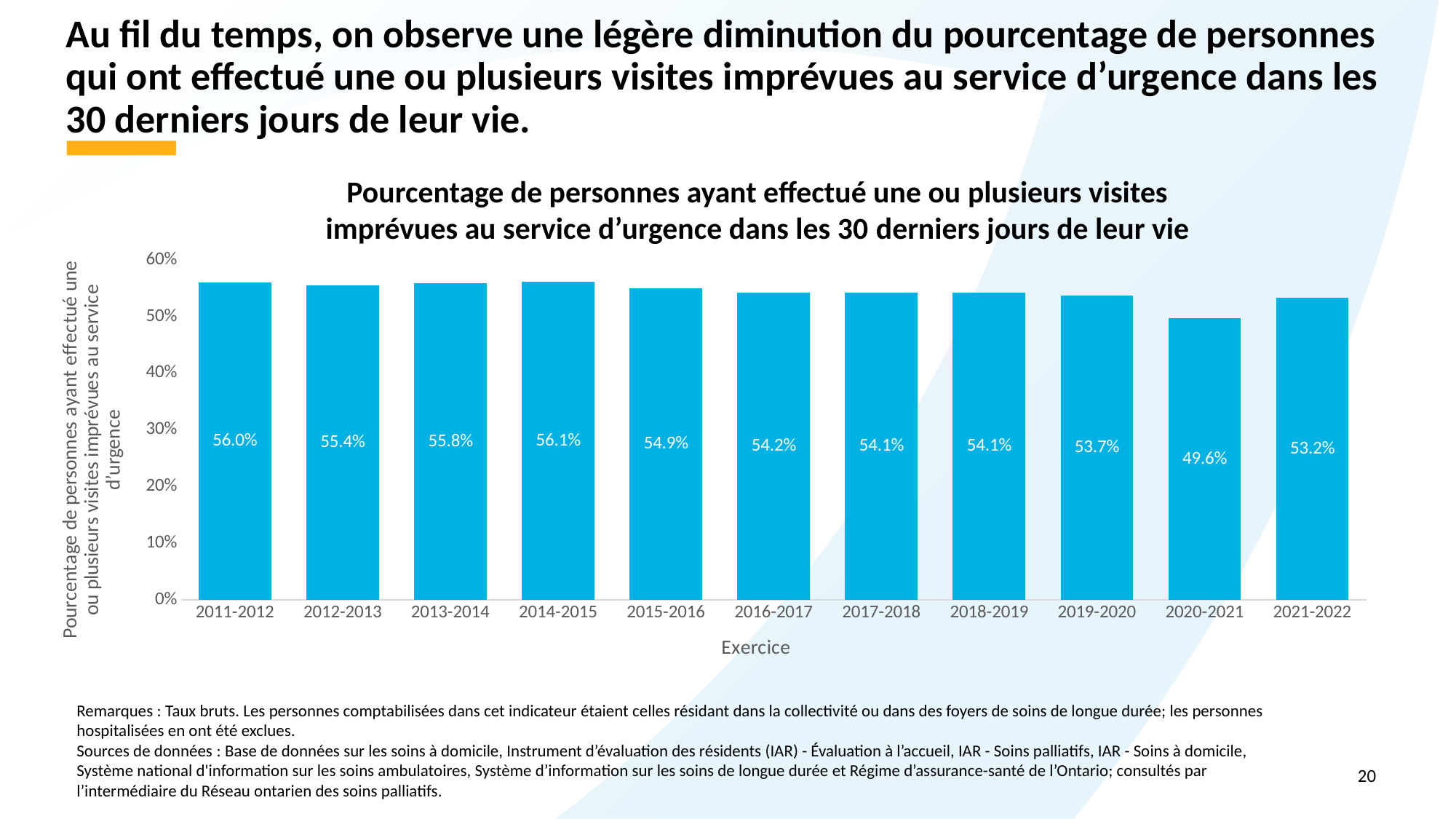
Is the value for 2020-2021 greater or less than 50%? less What is the difference between the values for 2011-2012 and 2021-2022? 2.8% Which is larger, the value for 2019-2020 or the value for 2020-2021? 2019-2020 Which fiscal year has the lowest value? 2020-2021 What is the value for 2021-2022? 53.2% Which fiscal year has the highest value? 2014-2015 What kind of chart is shown on the slide? bar chart What is the label of the x axis? Exercice What is the value for 2020-2021? 49.6% What is the value for 2011-2012? 56.0% How many fiscal years are shown on the x axis? 11 What is the value for 2016-2017? 54.2%